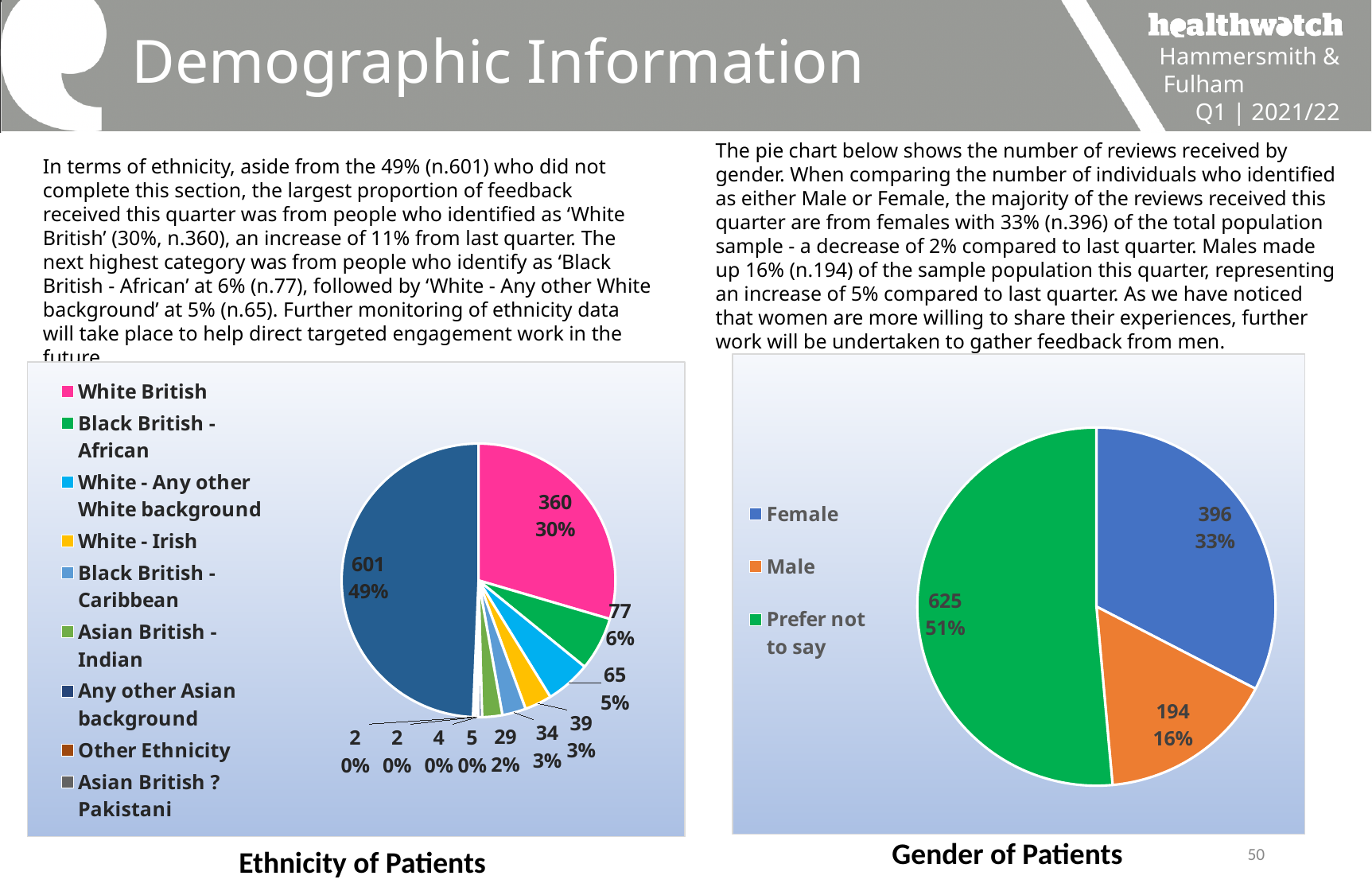
In the Gender of Patients chart, what is the value for Prefer not to say? 625 In the Ethnicity of Patients chart, what is the difference between the White British and Black British - African values? 283 In the Gender of Patients chart, how many reviews were from Female respondents? 396 In the Gender of Patients chart, what share of the pie is Male? 16% In the Ethnicity of Patients chart, what is the value for White British? 360 What kind of chart is the Gender of Patients chart? Pie chart In the Ethnicity of Patients chart, what share of the pie is Black British - African? 6% In the Gender of Patients chart, which category has the largest slice? Prefer not to say In the Gender of Patients chart, which category has the smallest slice? Male In the Ethnicity of Patients chart, which is larger: White British or Black British - African? White British In the Gender of Patients chart, what is the difference between the Female and Male counts? 202 How many entries does the legend of the Gender of Patients chart list? 3